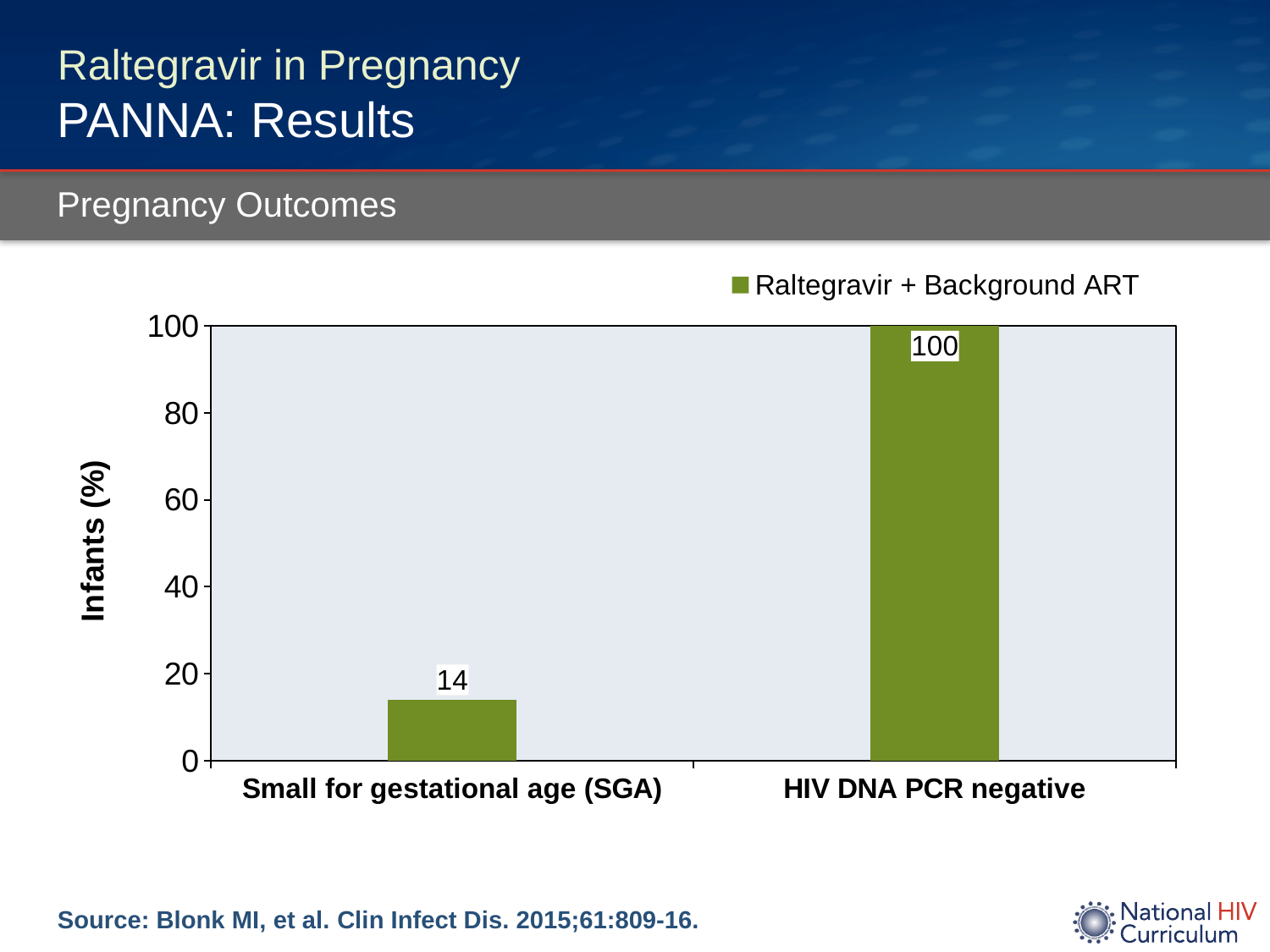
Which is larger, the value for Small for gestational age (SGA) or the value for HIV DNA PCR negative? HIV DNA PCR negative What is the value for HIV DNA PCR negative? 100 What kind of chart is shown on the slide? bar chart Is the value for Small for gestational age (SGA) greater or less than 20? less What is the label of the y axis? Infants (%) What is the difference between the values for HIV DNA PCR negative and Small for gestational age (SGA)? 86 Which category has the lowest value? Small for gestational age (SGA) How many categories are shown on the x axis? 2 What series name is shown in the legend? Raltegravir + Background ART How many series does the legend list? 1 Which category has the highest value? HIV DNA PCR negative What is the value for Small for gestational age (SGA)? 14